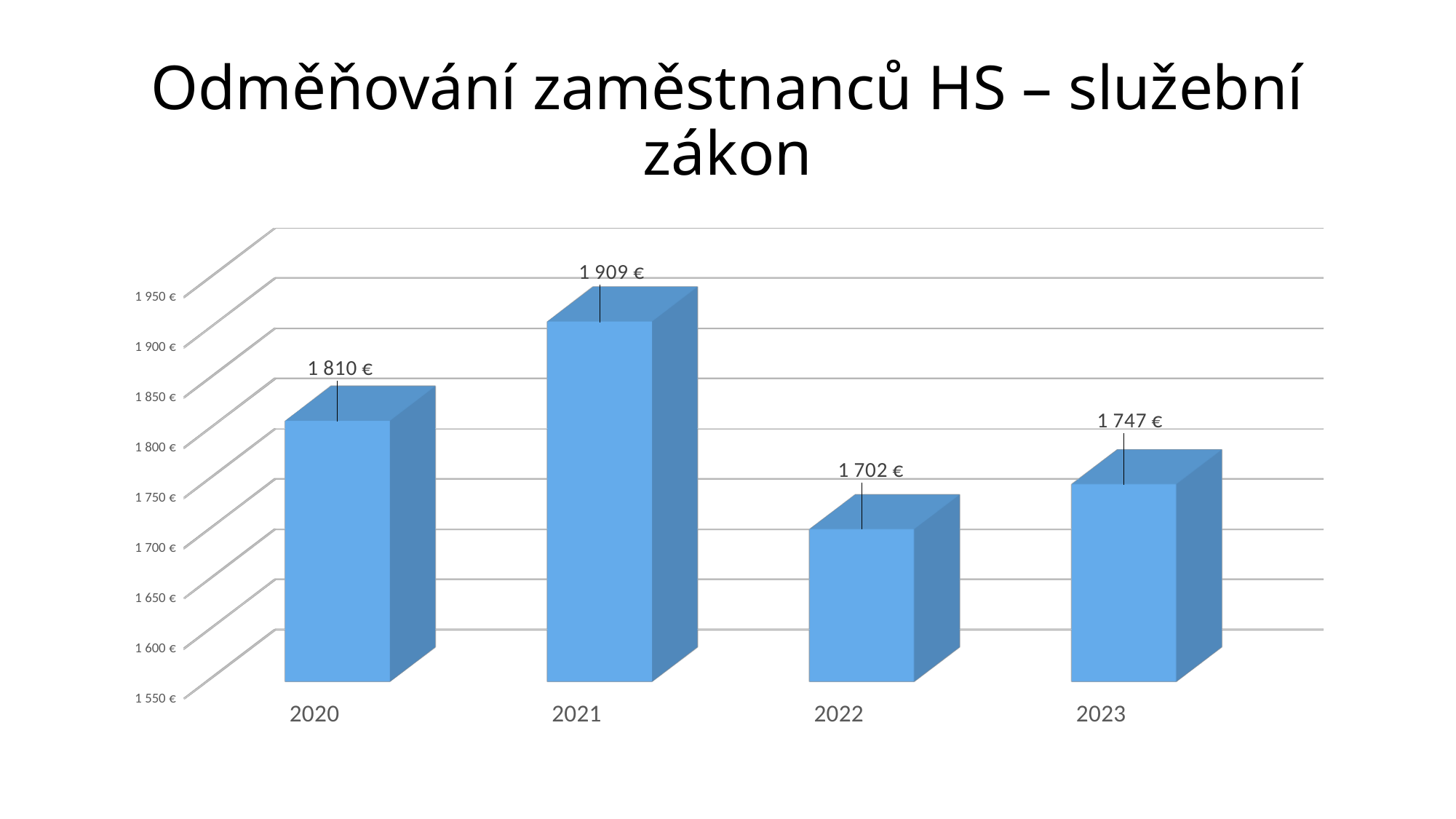
What is the difference between the values for 2023 and 2022? 45 € How many years are shown on the x axis? 4 What kind of chart is shown on the slide? Bar chart Which year has the highest value? 2021 Which is larger, the value for 2020 or the value for 2023? 2020 What is the difference between the values for 2021 and 2020? 99 € What is the value for 2023? 1 747 € What is the title of the slide? Odměňování zaměstnanců HS – služební zákon What is the value for 2021? 1 909 € What is the value for 2020? 1 810 € What is the value for 2022? 1 702 € Which year has the lowest value? 2022